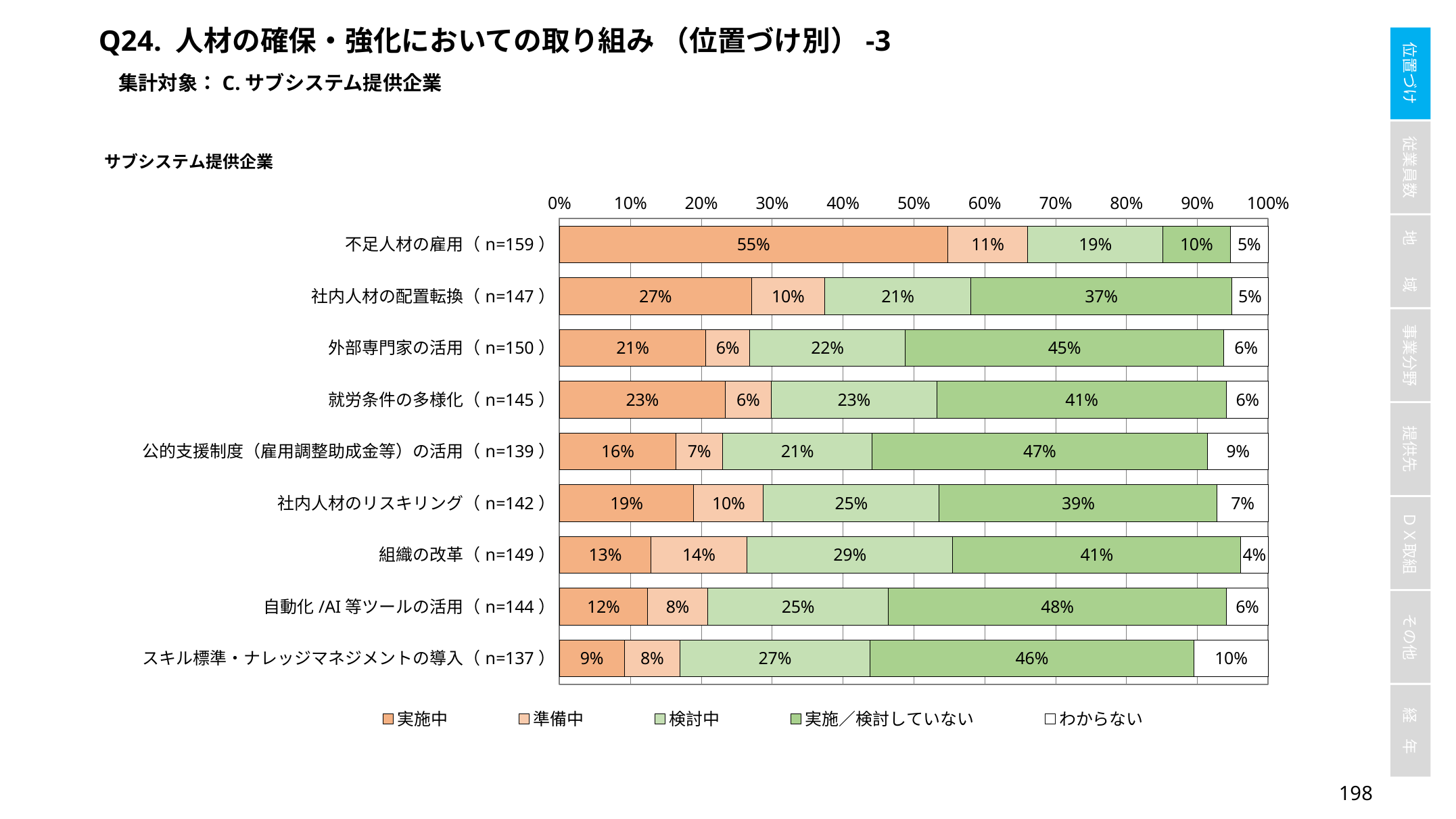
Which category has the highest 実施／検討していない value? 自動化/AI等ツールの活用 What is the n value shown for 就労条件の多様化? n=145 How many series does the legend list? 5 How many categories (取り組み) are plotted in the chart? 9 Which category has the lowest 実施中 value? スキル標準・ナレッジマネジメントの導入 What is the 実施／検討していない value for 自動化/AI等ツールの活用? 48% Which category has the highest 実施中 value? 不足人材の雇用 What is the difference between the 実施中 values for 不足人材の雇用 and 社内人材の配置転換? 28% What is the わからない value for スキル標準・ナレッジマネジメントの導入? 10% What kind of chart is shown on the slide? Stacked bar chart What is the 実施中 value for 不足人材の雇用? 55% Which is larger: the 検討中 value for 組織の改革 or the 検討中 value for 外部専門家の活用? 組織の改革